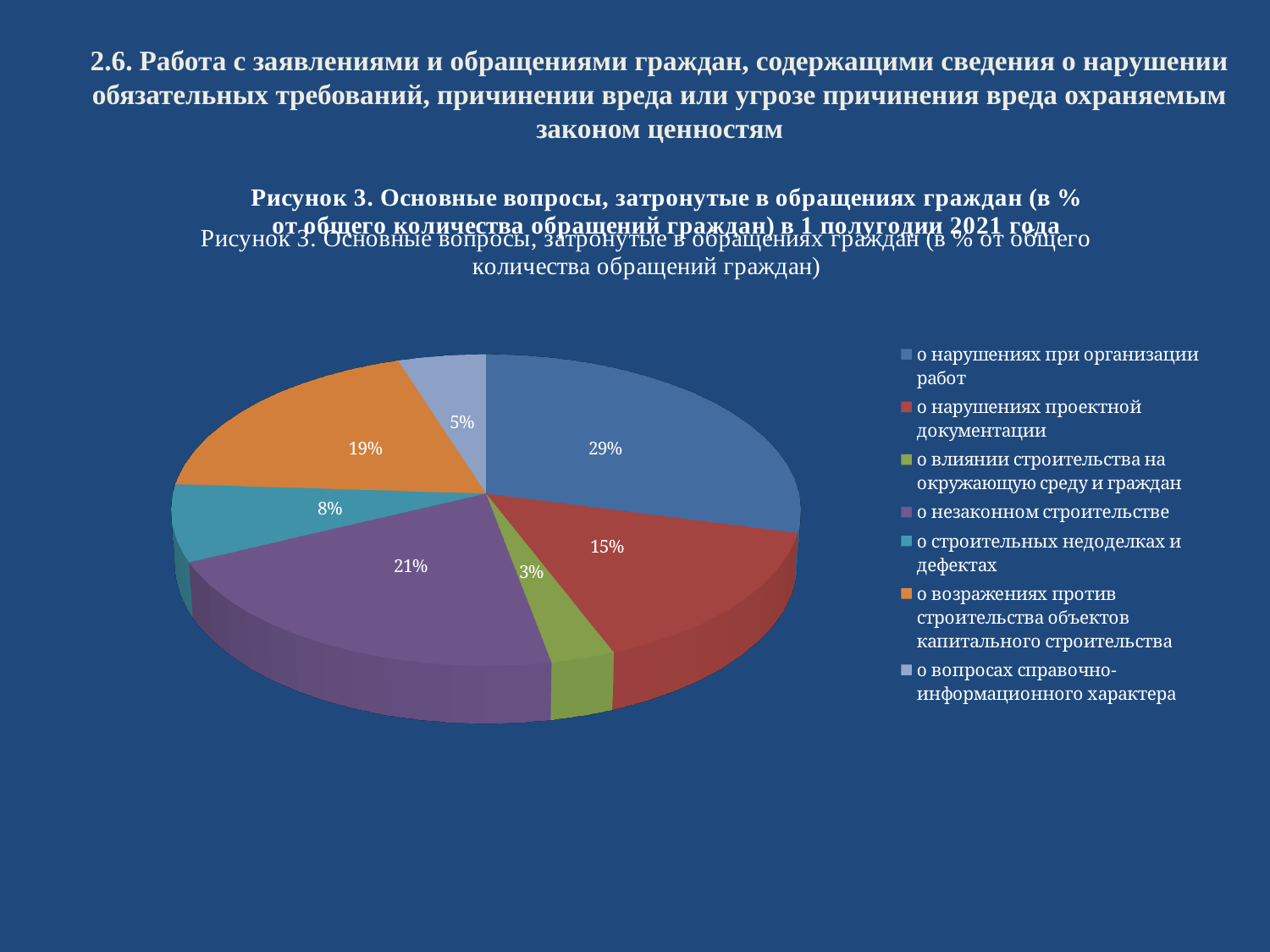
What is the difference in percentage points between the share for illegal construction (21%) and the share for objections against construction of capital construction objects (19%)? 2 Which category has the largest share of appeals? о нарушениях при организации работ Which is larger: the share for violations of project documentation or the share for reference and information questions (о вопросах справочно-информационного характера)? о нарушениях проектной документации How many entries does the legend list? 7 What share of appeals concerns objections against construction of capital construction objects (о возражениях против строительства объектов капитального строительства)? 19% Which category has the smallest share of appeals? о влиянии строительства на окружающую среду и граждан What share of appeals concerns illegal construction (о незаконном строительстве)? 21% What share of appeals concerns construction defects and unfinished work (о строительных недоделках и дефектах)? 8% How many slices does the pie chart have? 7 What kind of chart is shown on the slide? pie chart What share of citizens' appeals concerns violations in the organisation of works (о нарушениях при организации работ)? 29% What share of appeals concerns violations of project documentation (о нарушениях проектной документации)? 15%